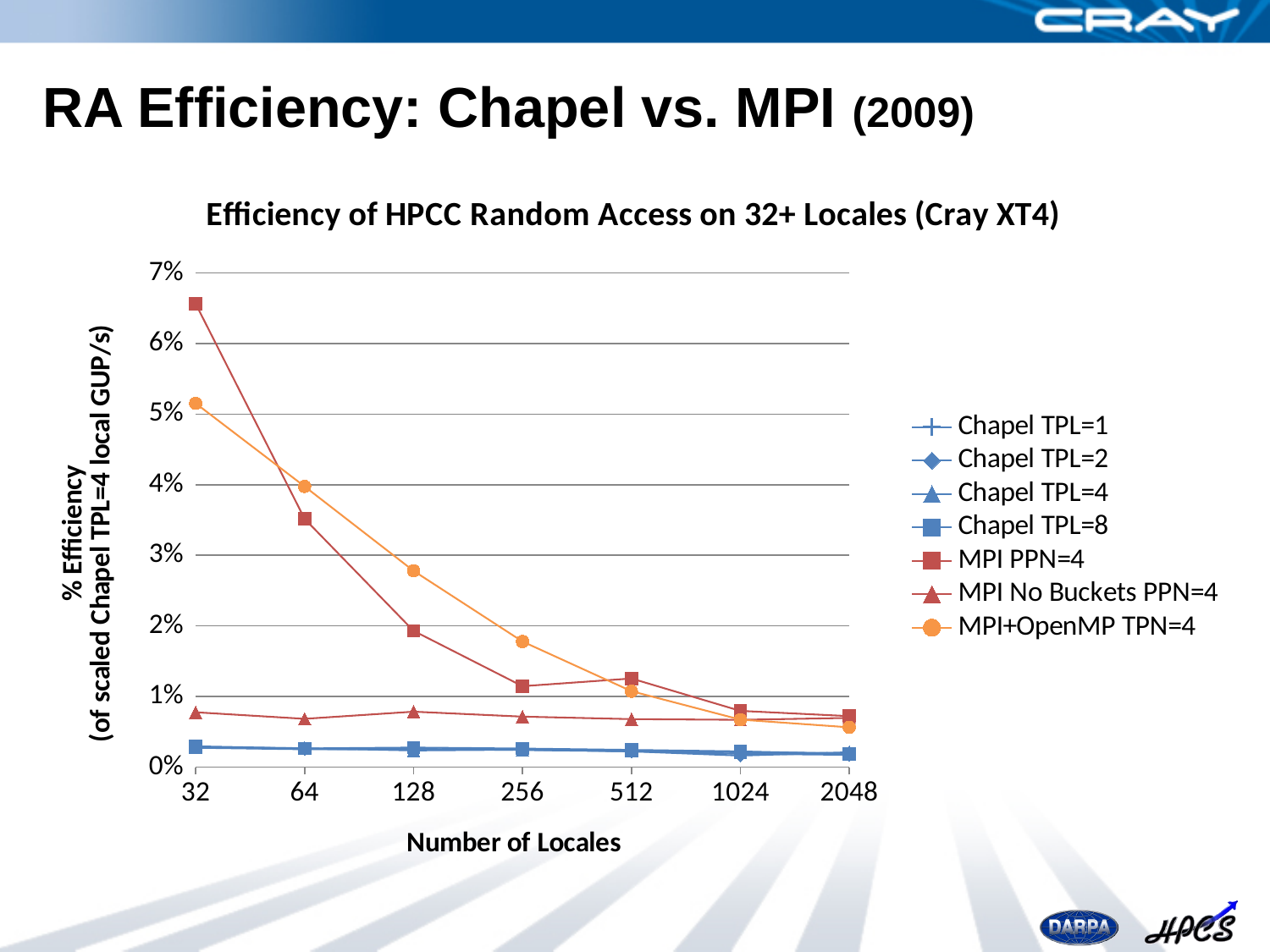
What kind of chart is shown on the slide? line chart What is the title of the chart? Efficiency of HPCC Random Access on 32+ Locales (Cray XT4) Does the MPI PPN=4 series rise or fall as the number of locales increases? fall Which series has the highest efficiency at 32 locales? MPI PPN=4 Is the value for MPI+OpenMP TPN=4 at 32 locales greater or less than 6%? less At 32 locales, which is larger: MPI PPN=4 or MPI+OpenMP TPN=4? MPI PPN=4 How many series does the legend list? 7 At 128 locales, which is larger: MPI PPN=4 or MPI+OpenMP TPN=4? MPI+OpenMP TPN=4 How many values are shown on the Number of Locales axis? 7 Is the value for MPI PPN=4 at 32 locales greater or less than 6%? greater Is the value for MPI No Buckets PPN=4 at 32 locales greater or less than 1%? less